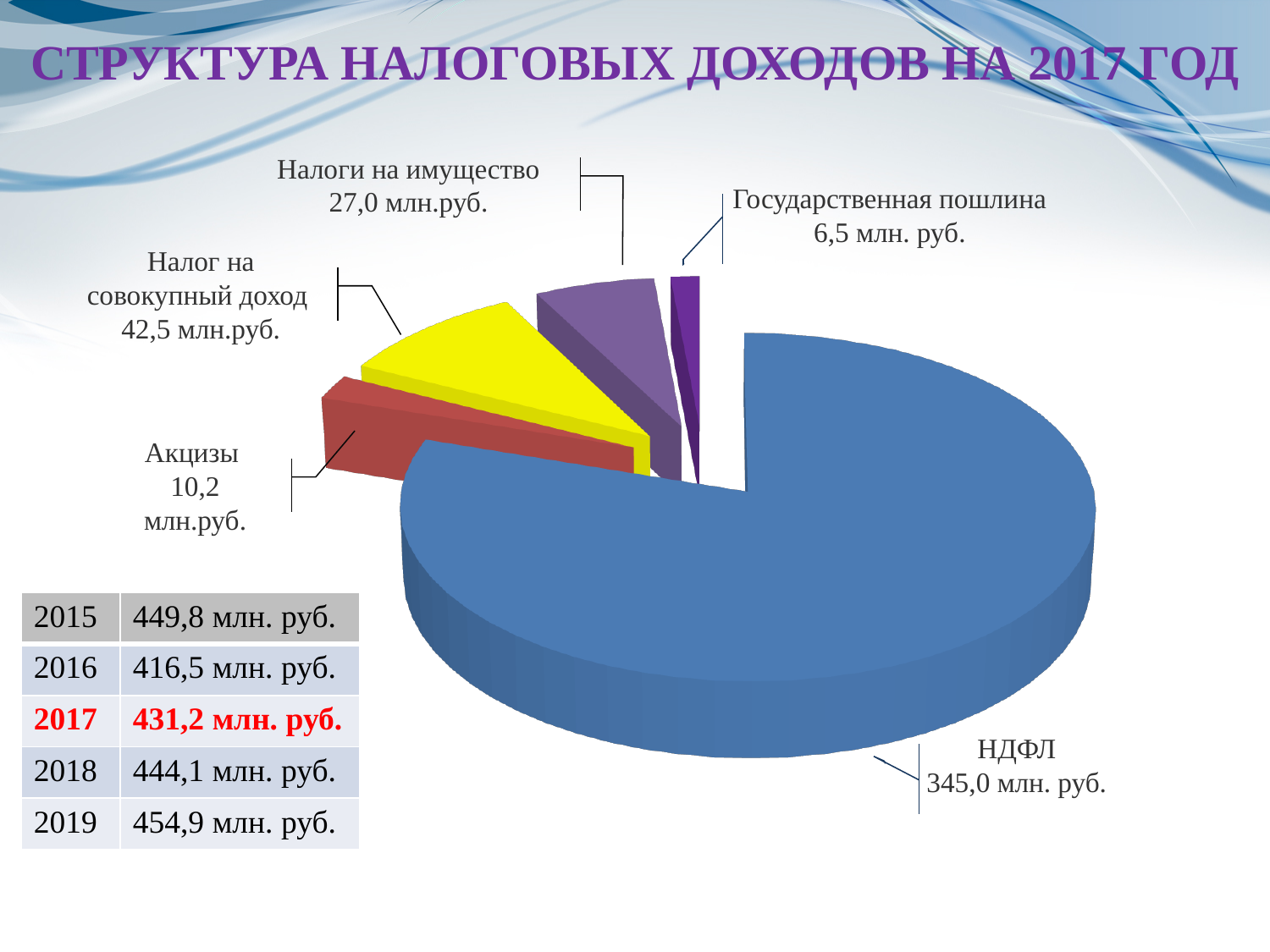
What is the value for НДФЛ in the pie chart? 345,0 млн. руб. What is the value for Налоги на имущество in the pie chart? 27,0 млн.руб. How many slices does the pie chart have? 5 Which category has the smallest slice in the pie chart? Государственная пошлина What is the value for Государственная пошлина in the pie chart? 6,5 млн. руб. Which category has the largest slice in the pie chart? НДФЛ What is the value for Налог на совокупный доход in the pie chart? 42,5 млн.руб. What is the difference between the values for Налог на совокупный доход and Налоги на имущество? 15,5 млн.руб. Which is larger in the pie chart: Акцизы or Государственная пошлина? Акцизы What is the value for Акцизы in the pie chart? 10,2 млн.руб. What is the title of the slide containing the pie chart? СТРУКТУРА НАЛОГОВЫХ ДОХОДОВ НА 2017 ГОД What kind of chart is shown on the slide? pie chart